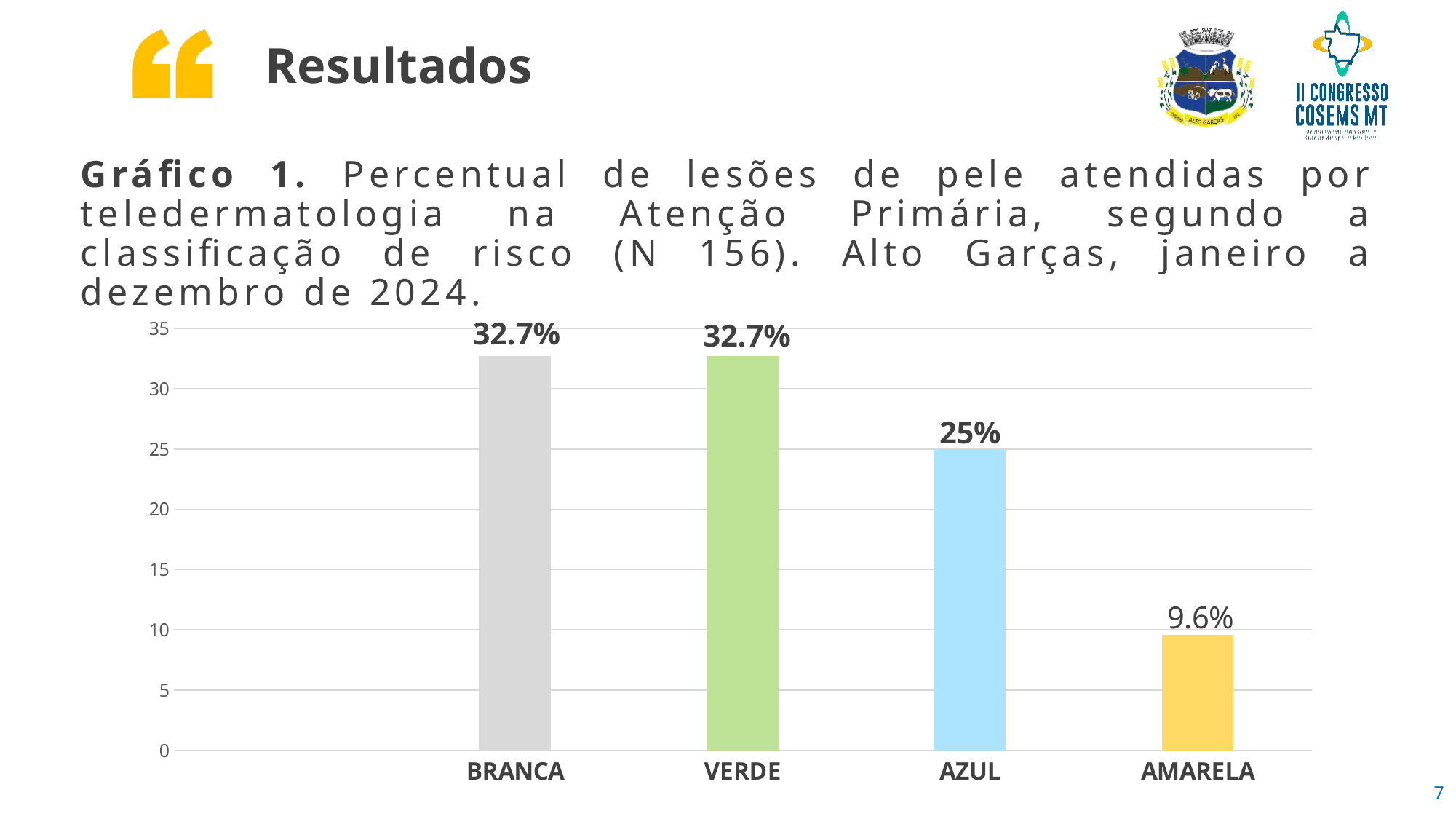
What colour is the bar for AZUL? light blue What is the value for VERDE? 32.7% What is the value for BRANCA? 32.7% What kind of chart is shown on the slide? bar chart How many categories are shown on the x axis? 4 Which is larger, the value for VERDE or the value for AZUL? VERDE What is the difference between the values for AZUL and AMARELA? 15.4% What is the value for AZUL? 25% Is the value for AMARELA greater or less than 10? less What is the value for AMARELA? 9.6% What is the difference between the values for BRANCA and AZUL? 7.7% Which category has the lowest value? AMARELA